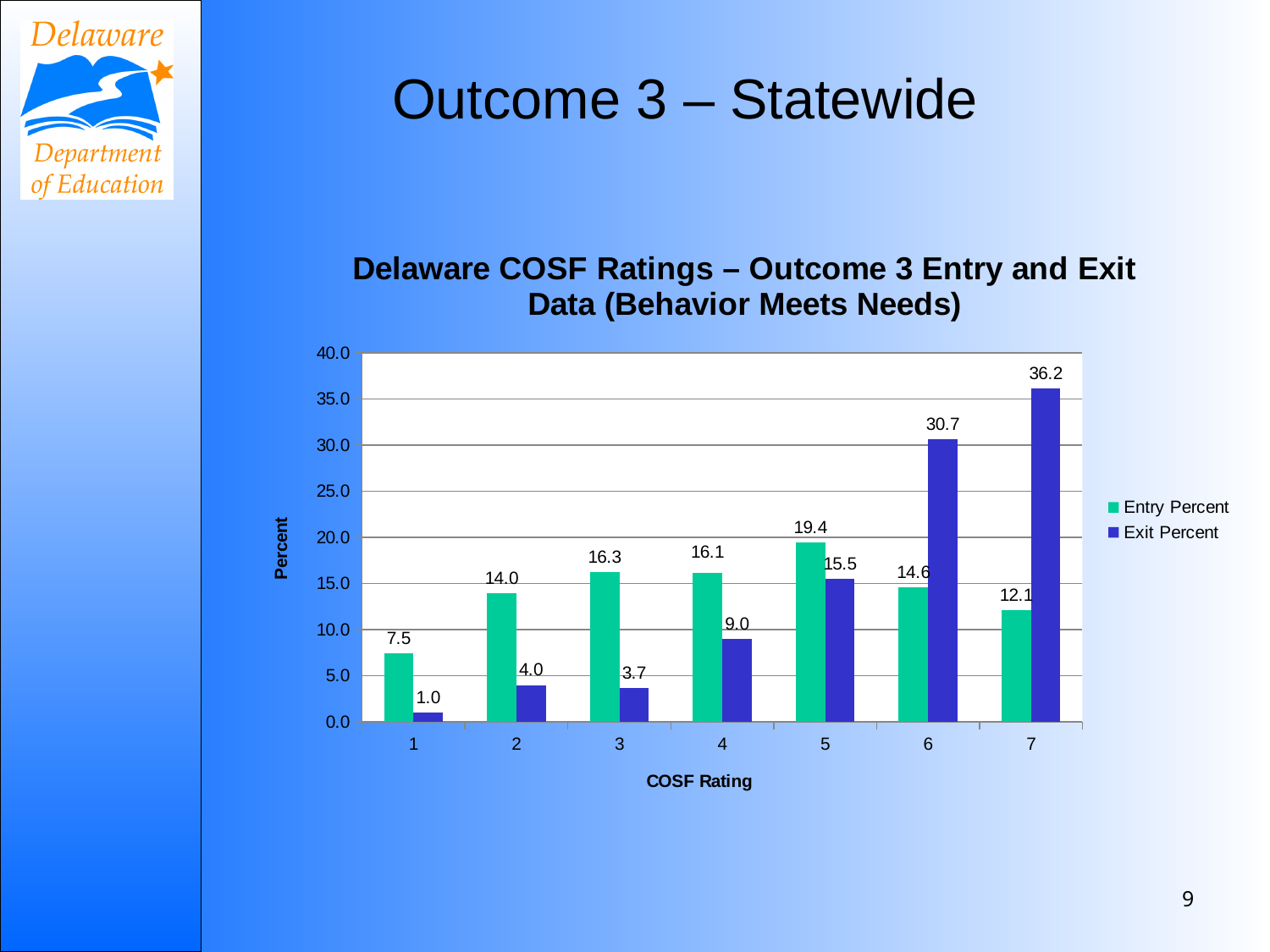
Which COSF Rating has the lowest Entry Percent? 1 For COSF Rating 4, which is larger, the Entry Percent or the Exit Percent? Entry Percent What is the difference between the Exit Percent and the Entry Percent for COSF Rating 6? 16.1 What is the Exit Percent for COSF Rating 7? 36.2 What kind of chart is shown on the slide? Bar chart Does the Exit Percent rise or fall from COSF Rating 4 to COSF Rating 7? Rise Is the Exit Percent for COSF Rating 6 greater or less than 25.0? greater What is the Exit Percent for COSF Rating 3? 3.7 How many series does the legend list? 2 Which COSF Rating has the highest Exit Percent? 7 How many COSF Rating categories are shown on the x axis? 7 What is the Entry Percent for COSF Rating 5? 19.4